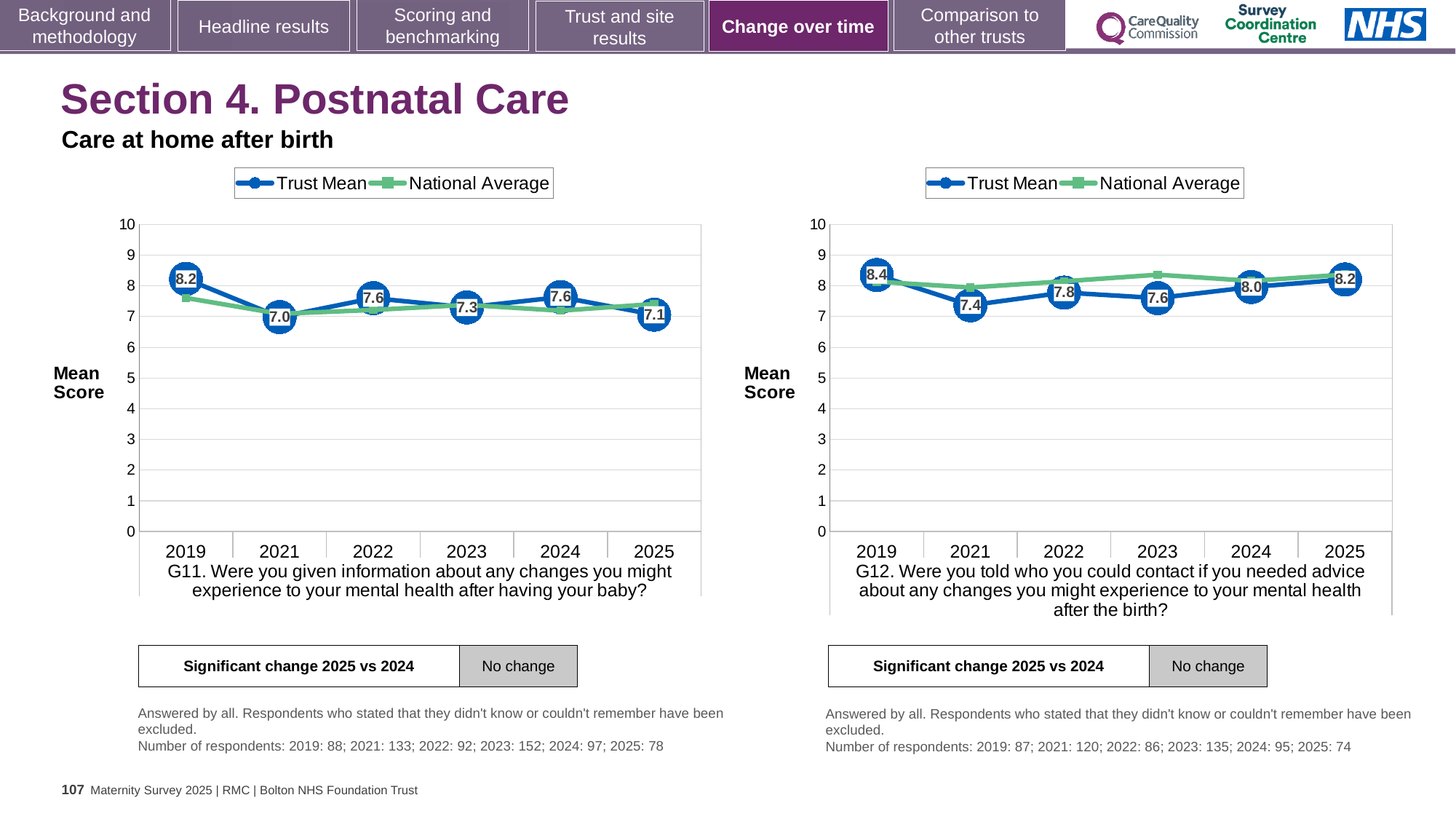
In the G12 chart on the right, which year has the highest Trust Mean? 2019 In the G11 chart on the left, which year has the lowest Trust Mean? 2021 In the G11 chart on the left, what is the Trust Mean for 2025? 7.1 How many years are shown on the x axis of the G11 chart on the left? 6 In the G11 chart on the left, is the Trust Mean higher in 2022 or in 2023? 2022 In the G12 chart on the right, what is the difference between the Trust Mean for 2019 and the Trust Mean for 2021? 1.0 In the G11 chart on the left, what is the Trust Mean for 2019? 8.2 What kind of chart is the G11 chart on the left? Line chart How many series does the legend of the G12 chart on the right list? 2 In the G12 chart on the right, is the National Average for 2023 greater or less than 8? greater In the G12 chart on the right, does the Trust Mean rise or fall from 2023 to 2025? Rise In the G12 chart on the right, what is the Trust Mean for 2024? 8.0